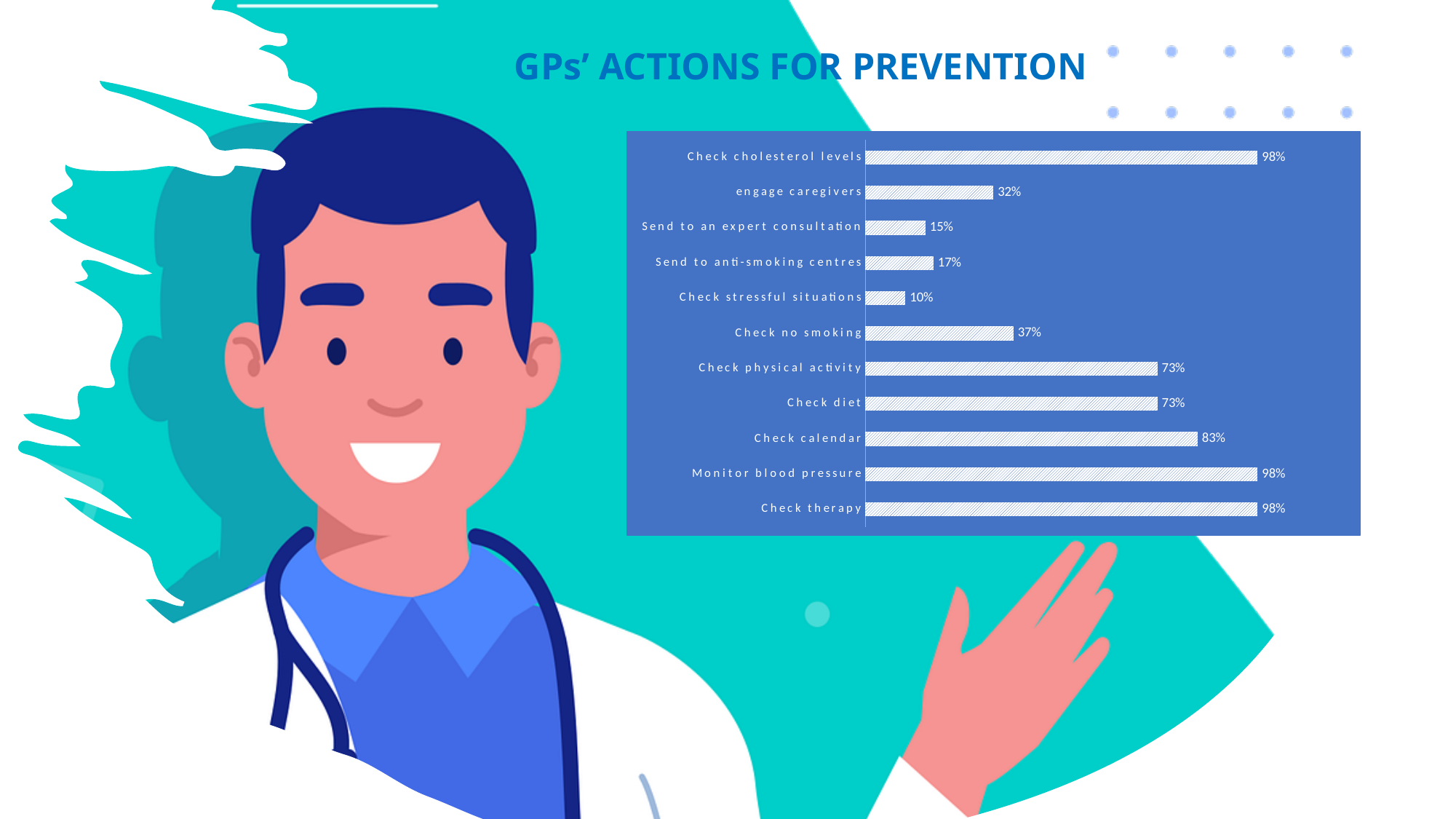
What is the difference between Check calendar and Check physical activity? 10% What is the difference between Check no smoking and Check stressful situations? 27% What is the value for Send to anti-smoking centres? 17% What is the value for Check no smoking? 37% Which is larger, engage caregivers or Check no smoking? Check no smoking What is the value for Check calendar? 83% What is the value for engage caregivers? 32% How many categories are shown in the chart? 11 What is the title of the slide? GPs' ACTIONS FOR PREVENTION What kind of chart is shown on the slide? Bar chart Which category has the lowest value? Check stressful situations Which is larger, Send to an expert consultation or Send to anti-smoking centres? Send to anti-smoking centres